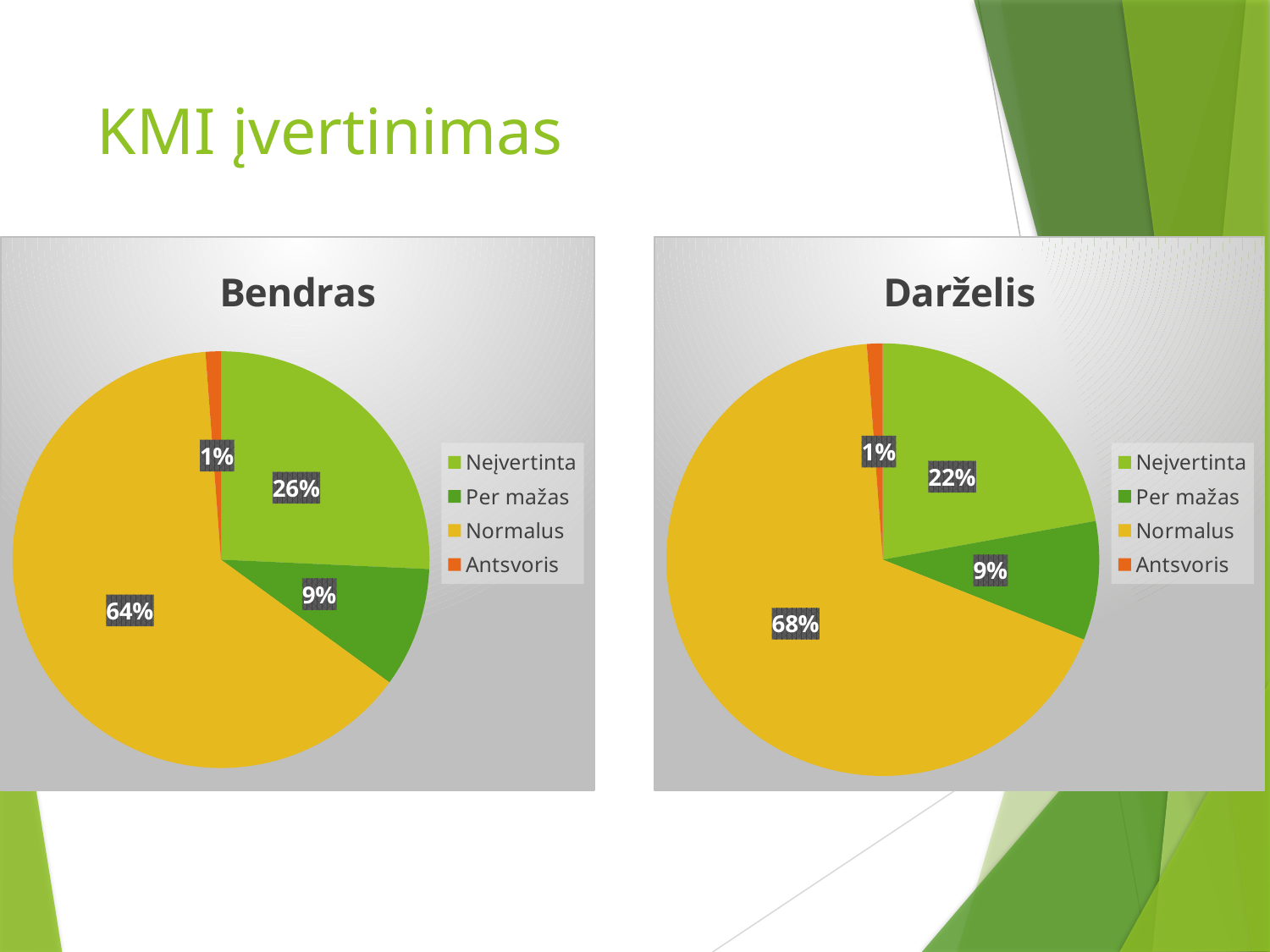
In the "Darželis" chart, which category has the smallest slice? Antsvoris What is the difference between the Normalus share in the "Darželis" chart and the Normalus share in the "Bendras" chart? 4% How many categories does the legend of the "Darželis" chart list? 4 What type of chart is the "Bendras" chart? Pie chart In the "Bendras" chart, what share does the Normalus slice have? 64% In the "Bendras" chart, which category has the largest slice? Normalus In the "Bendras" chart, what is the value for Per mažas? 9% Which is larger in the "Bendras" chart: Neįvertinta or Per mažas? Neįvertinta In the "Darželis" chart, what is the value for Neįvertinta? 22% In the "Bendras" chart, what is the value for Neįvertinta? 26% In the "Darželis" chart, what is the value for Antsvoris? 1% In the "Darželis" chart, what share does the Normalus slice have? 68%